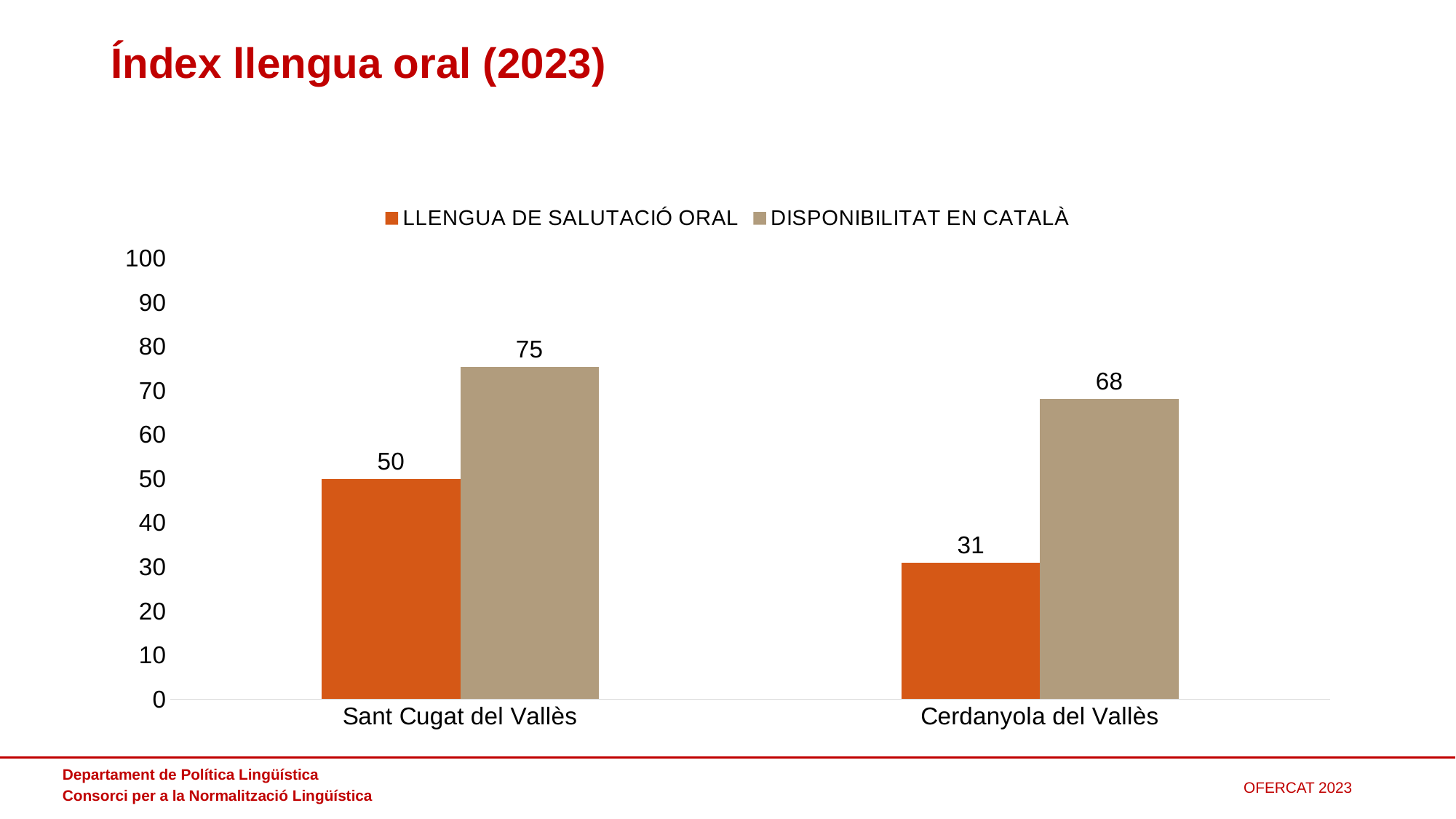
What is the difference in LLENGUA DE SALUTACIÓ ORAL between Sant Cugat del Vallès and Cerdanyola del Vallès? 19 How many series does the legend list? 2 Which is larger: LLENGUA DE SALUTACIÓ ORAL for Sant Cugat del Vallès or DISPONIBILITAT EN CATALÀ for Cerdanyola del Vallès? DISPONIBILITAT EN CATALÀ for Cerdanyola del Vallès What is the value of LLENGUA DE SALUTACIÓ ORAL for Cerdanyola del Vallès? 31 How many municipalities are shown on the x axis? 2 What kind of chart is shown on the slide? Bar chart Which municipality has the lowest value for LLENGUA DE SALUTACIÓ ORAL? Cerdanyola del Vallès What is the value of DISPONIBILITAT EN CATALÀ for Cerdanyola del Vallès? 68 What is the difference between DISPONIBILITAT EN CATALÀ and LLENGUA DE SALUTACIÓ ORAL for Cerdanyola del Vallès? 37 Which municipality has the highest value for DISPONIBILITAT EN CATALÀ? Sant Cugat del Vallès What is the value of LLENGUA DE SALUTACIÓ ORAL for Sant Cugat del Vallès? 50 What is the value of DISPONIBILITAT EN CATALÀ for Sant Cugat del Vallès? 75